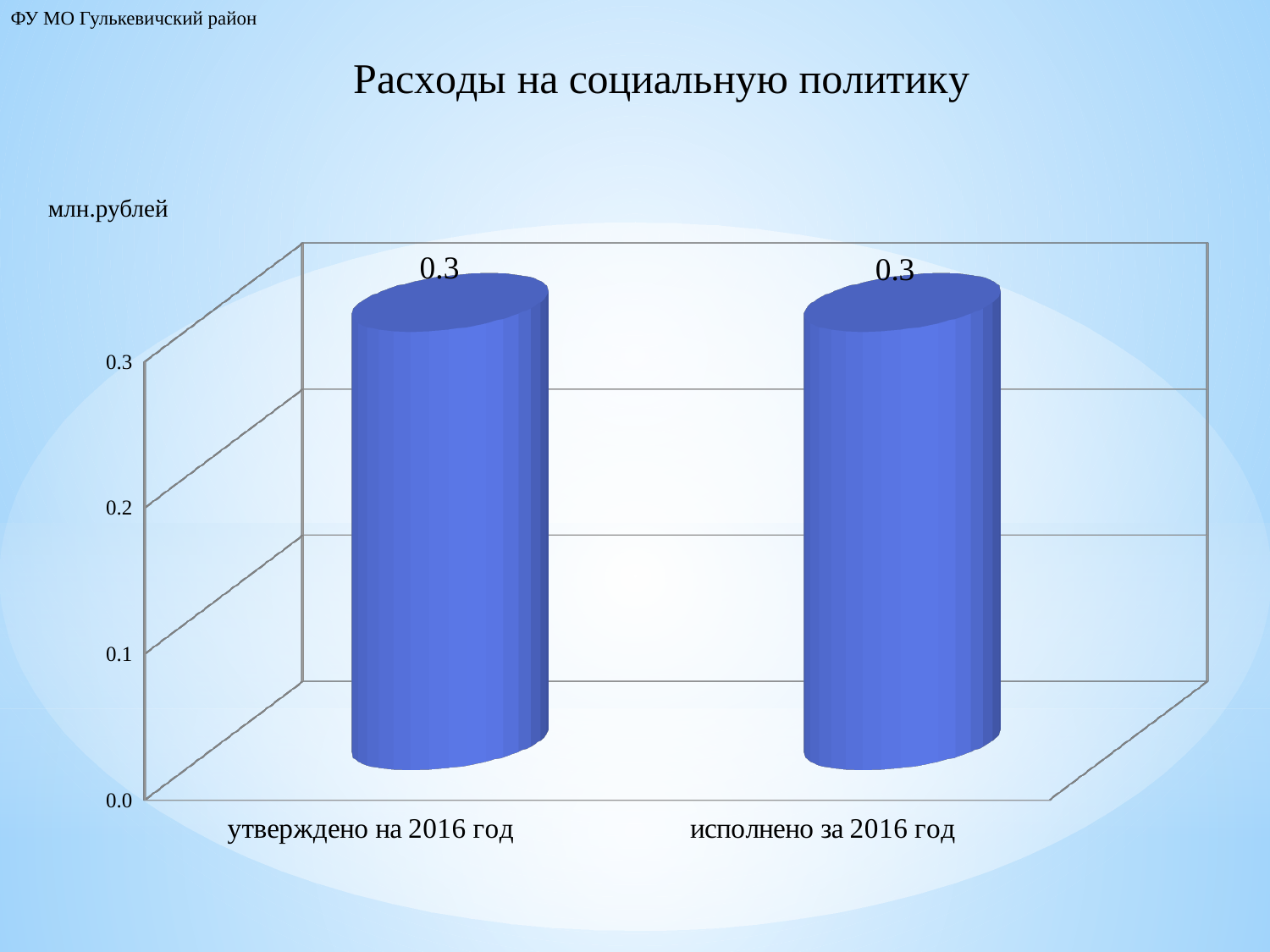
Is the value for 'исполнено за 2016 год' greater or less than 0.2? greater What kind of chart is shown on the slide? bar chart What is the value for 'утверждено на 2016 год'? 0.3 Is the value for 'утверждено на 2016 год' greater or less than 0.1? greater What is the title of the chart? Расходы на социальную политику In what units are the values on the chart expressed? млн.рублей Are the values for 'утверждено на 2016 год' and 'исполнено за 2016 год' equal? yes Do the values rise, fall or stay the same from 'утверждено на 2016 год' to 'исполнено за 2016 год'? stay the same What is the difference between the value for 'утверждено на 2016 год' and the value for 'исполнено за 2016 год'? 0.0 What is the value for 'исполнено за 2016 год'? 0.3 How many categories are shown on the x axis? 2